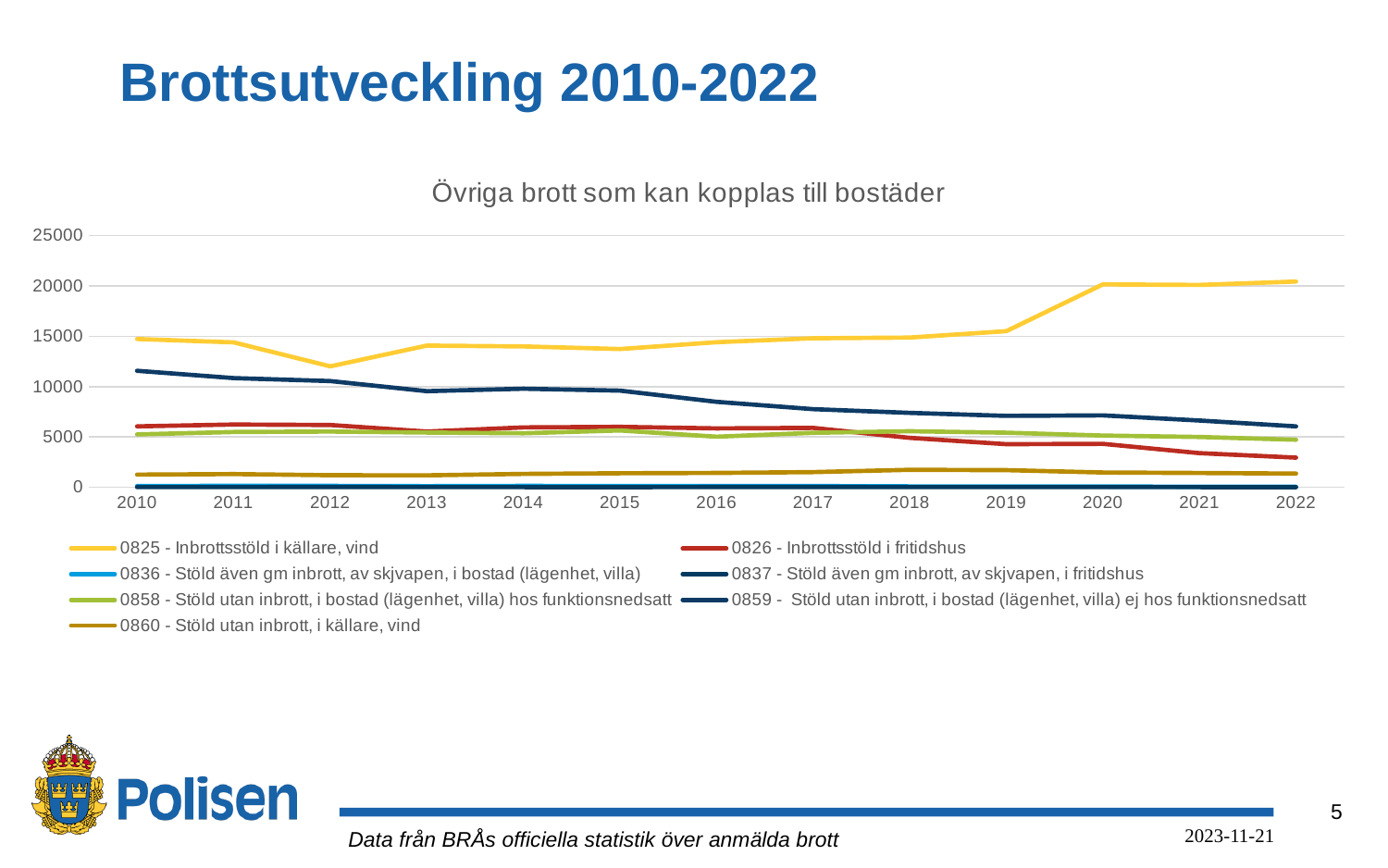
How many series does the legend list? 7 Does the line for 0859 - Stöld utan inbrott, i bostad (lägenhet, villa) ej hos funktionsnedsatt rise or fall from 2010 to 2022? fall Which series has the highest value in 2022? 0825 - Inbrottsstöld i källare, vind In 2022, which is larger: 0826 - Inbrottsstöld i fritidshus or 0858 - Stöld utan inbrott, i bostad (lägenhet, villa) hos funktionsnedsatt? 0858 - Stöld utan inbrott, i bostad (lägenhet, villa) hos funktionsnedsatt Is the value for 0859 - Stöld utan inbrott, i bostad (lägenhet, villa) ej hos funktionsnedsatt in 2010 greater or less than 10000? greater What is the title of the chart? Övriga brott som kan kopplas till bostäder Does the line for 0825 - Inbrottsstöld i källare, vind rise or fall from 2012 to 2022? rise How many years are shown along the x axis? 13 Is the value for 0825 - Inbrottsstöld i källare, vind in 2022 greater or less than 15000? greater Is the value for 0826 - Inbrottsstöld i fritidshus in 2022 greater or less than 5000? less What kind of chart is shown on the slide? line chart